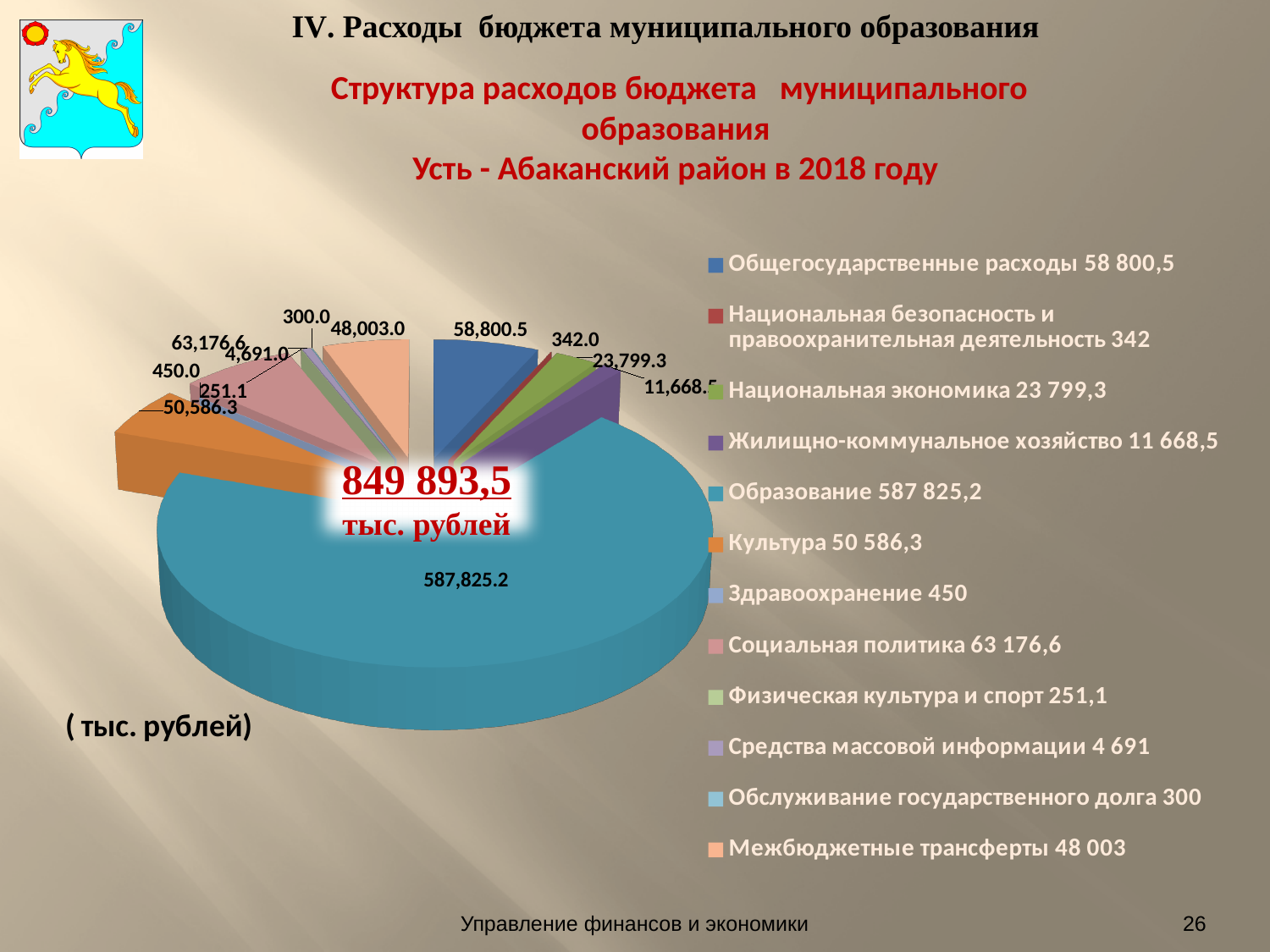
Which is larger, Национальная безопасность и правоохранительная деятельность or Обслуживание государственного долга? Национальная безопасность и правоохранительная деятельность Which is larger, Социальная политика or Культура? Социальная политика What total amount is printed in the centre of the pie chart? 849 893,5 тыс. рублей What value is shown for Межбюджетные трансферты in the pie chart? 48,003.0 How many categories (slices) does the pie chart have? 12 Which category has the largest slice in the pie chart? Образование Which category has the smallest slice in the pie chart? Физическая культура и спорт In what units are the values of the pie chart given? тыс. рублей What value is shown for Здравоохранение in the pie chart? 450.0 What is the difference between the values for Общегосударственные расходы and Межбюджетные трансферты? 10,797.5 What value is shown for Культура in the pie chart? 50,586.3 What type of chart is shown on the slide? Pie chart